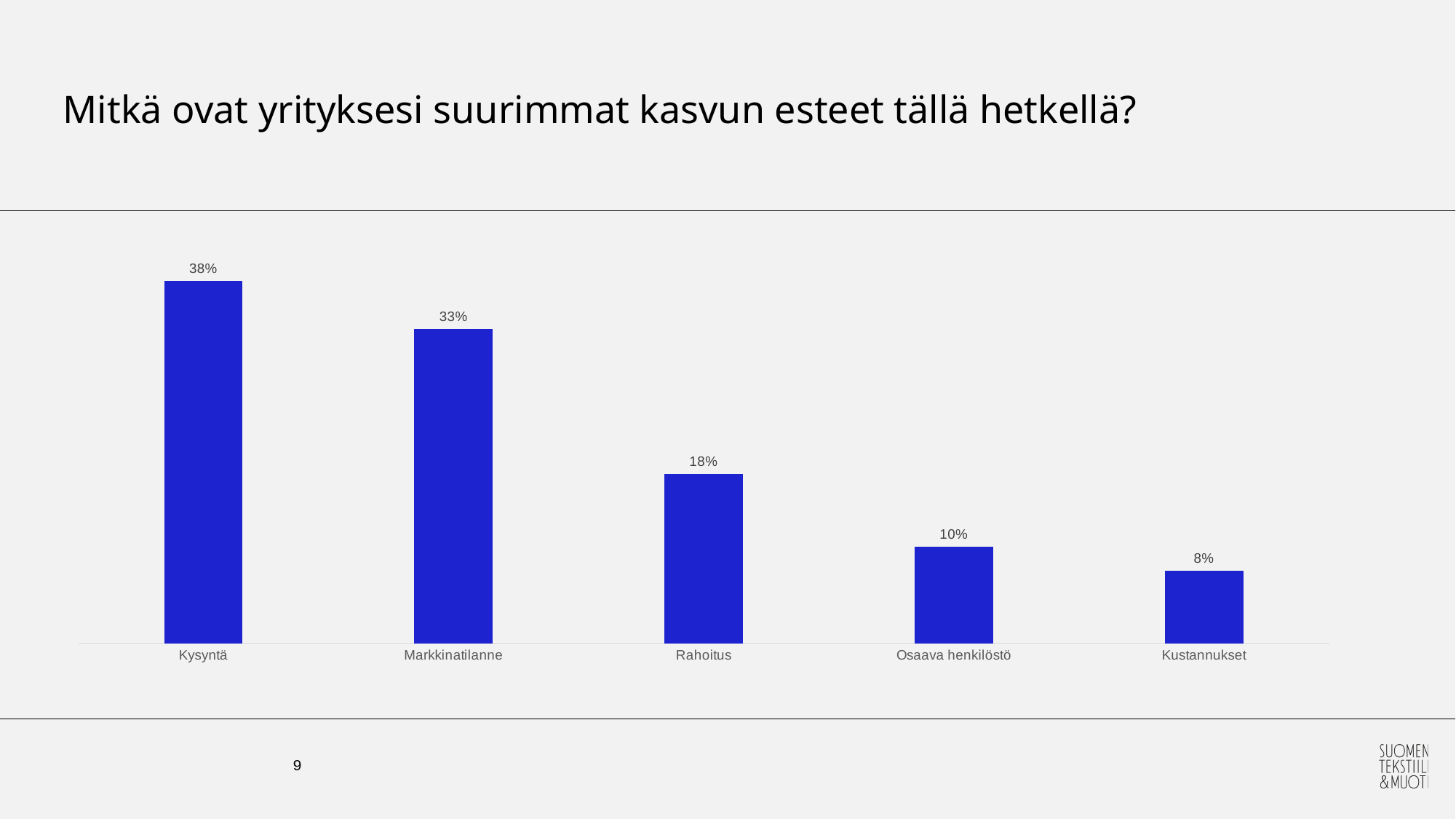
What is the value for Markkinatilanne? 33% Which category has the lowest value? Kustannukset How many categories are shown in the chart? 5 What kind of chart is shown on the slide? Bar chart Which category has the highest value? Kysyntä Which is larger, the value for Rahoitus or the value for Osaava henkilöstö? Rahoitus What is the value for Osaava henkilöstö? 10% What is the difference between the values for Kysyntä and Markkinatilanne? 5% What is the value for Kustannukset? 8% What is the value for Rahoitus? 18% What is the value for Kysyntä? 38% What is the difference between the values for Rahoitus and Kustannukset? 10%